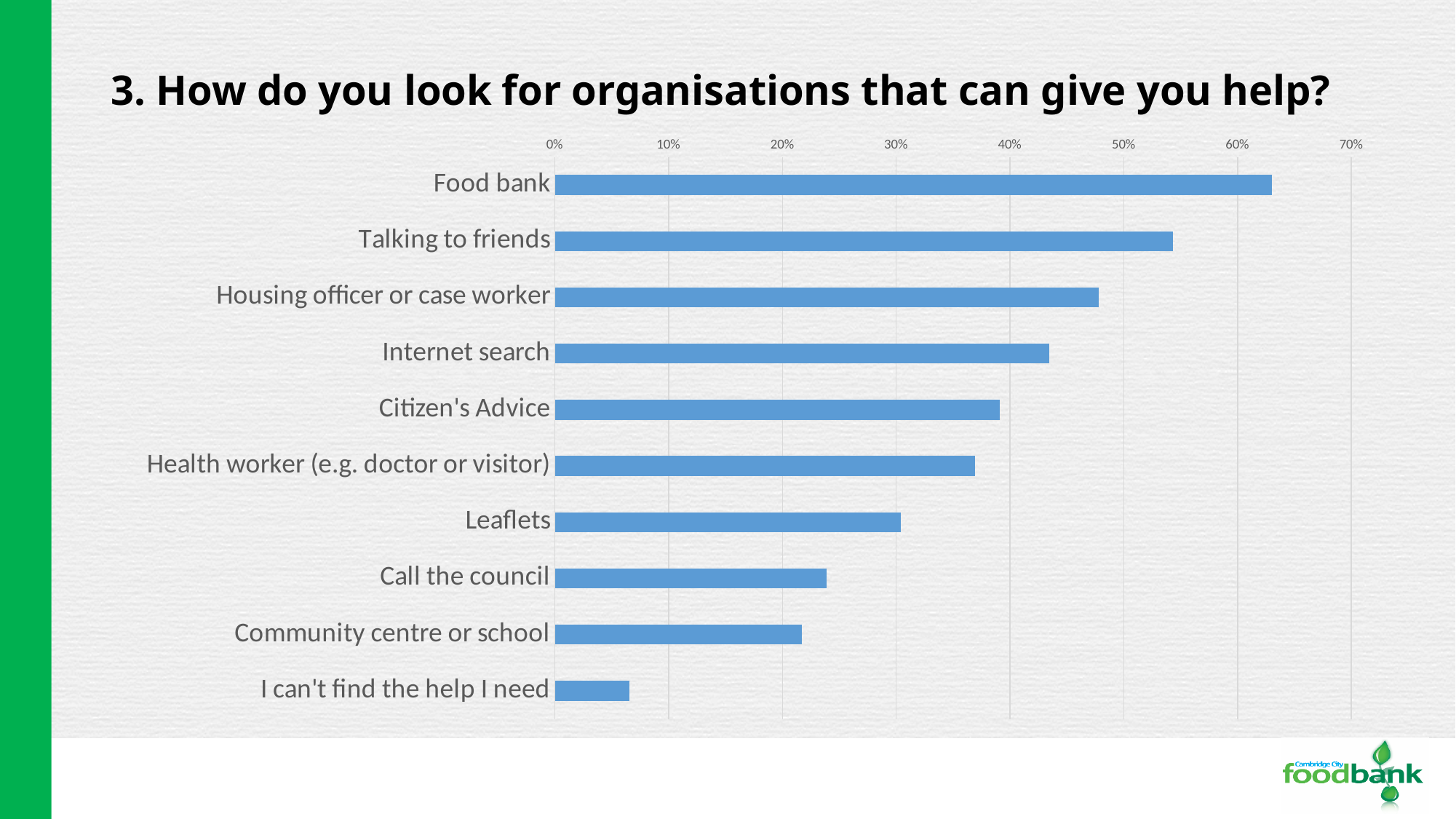
Which is larger, the value for Internet search or the value for Leaflets? Internet search How many categories are plotted in the chart? 10 Is the value for Housing officer or case worker greater or less than 50%? less Is the value for Food bank greater or less than 60%? greater Is the value for Talking to friends greater or less than 50%? greater Which category has the lowest value? I can't find the help I need Which is larger, the value for Call the council or the value for Citizen's Advice? Citizen's Advice Which category has the highest value? Food bank What kind of chart is shown on the slide? bar chart What is the title of the chart on the slide? 3. How do you look for organisations that can give you help?